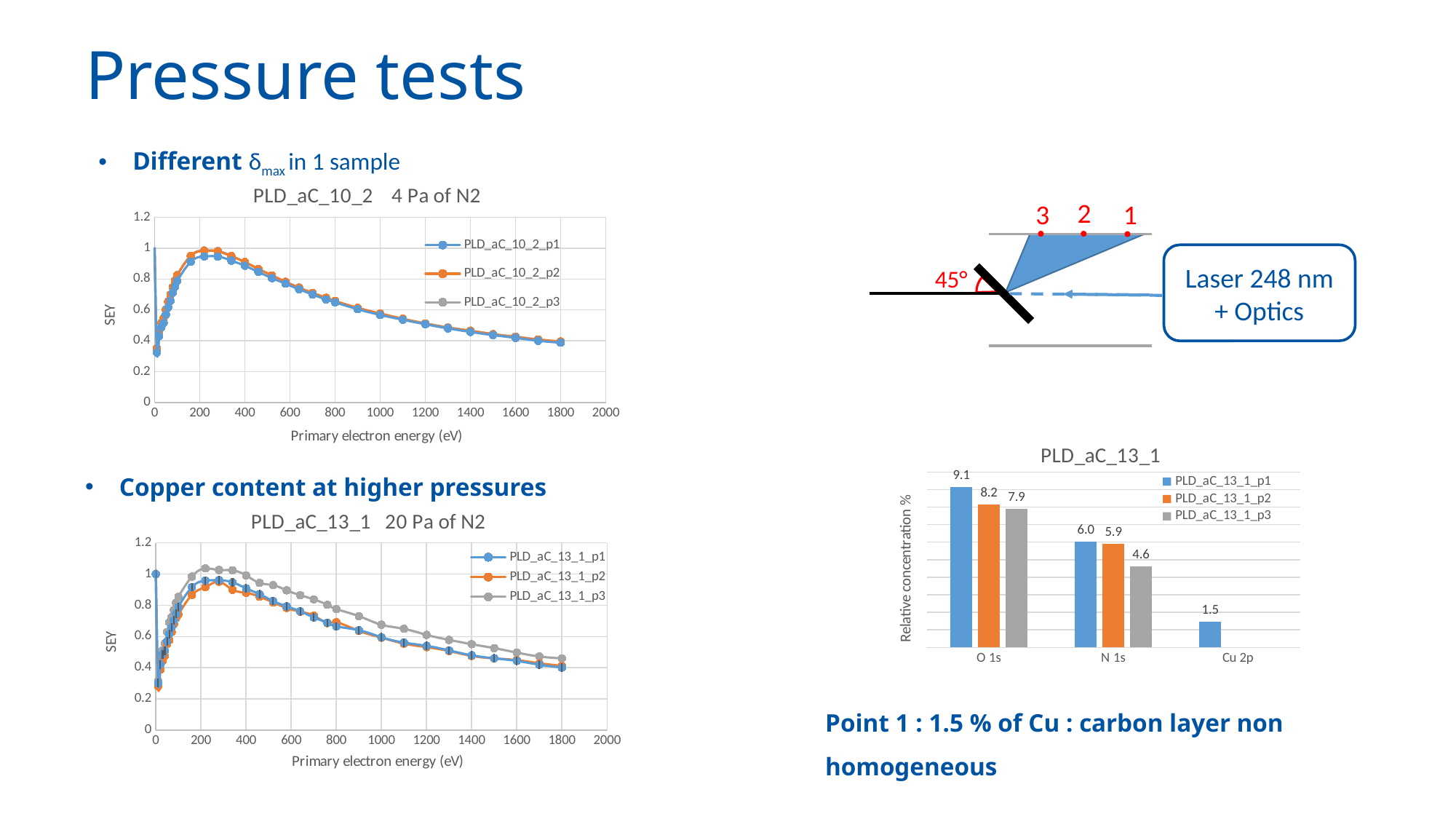
What kind of chart is the chart titled PLD_aC_13_1 on the right of the slide? bar chart In the bar chart titled PLD_aC_13_1, what is the difference between the PLD_aC_13_1_p1 and PLD_aC_13_1_p3 values at N 1s? 1.4 In the bar chart titled PLD_aC_13_1, is the PLD_aC_13_1_p2 value at O 1s larger or smaller than its value at N 1s? larger In the bar chart titled PLD_aC_13_1, which series has the highest value at O 1s? PLD_aC_13_1_p1 In the bar chart titled PLD_aC_13_1, what is the difference between the PLD_aC_13_1_p1 and PLD_aC_13_1_p3 values at O 1s? 1.2 In the bar chart titled PLD_aC_13_1, what is the value for PLD_aC_13_1_p1 at Cu 2p? 1.5 In the bar chart titled PLD_aC_13_1, which series has the lowest value at N 1s? PLD_aC_13_1_p3 In the bar chart titled PLD_aC_13_1, what is the value for PLD_aC_13_1_p3 at N 1s? 4.6 In the bar chart titled PLD_aC_13_1, how many categories are shown on the x axis? 3 In the bar chart titled PLD_aC_13_1, how many series does the legend list? 3 In the line chart titled PLD_aC_10_2 4 Pa of N2, how many series does the legend list? 3 In the bar chart titled PLD_aC_13_1, what is the value for PLD_aC_13_1_p1 at O 1s? 9.1